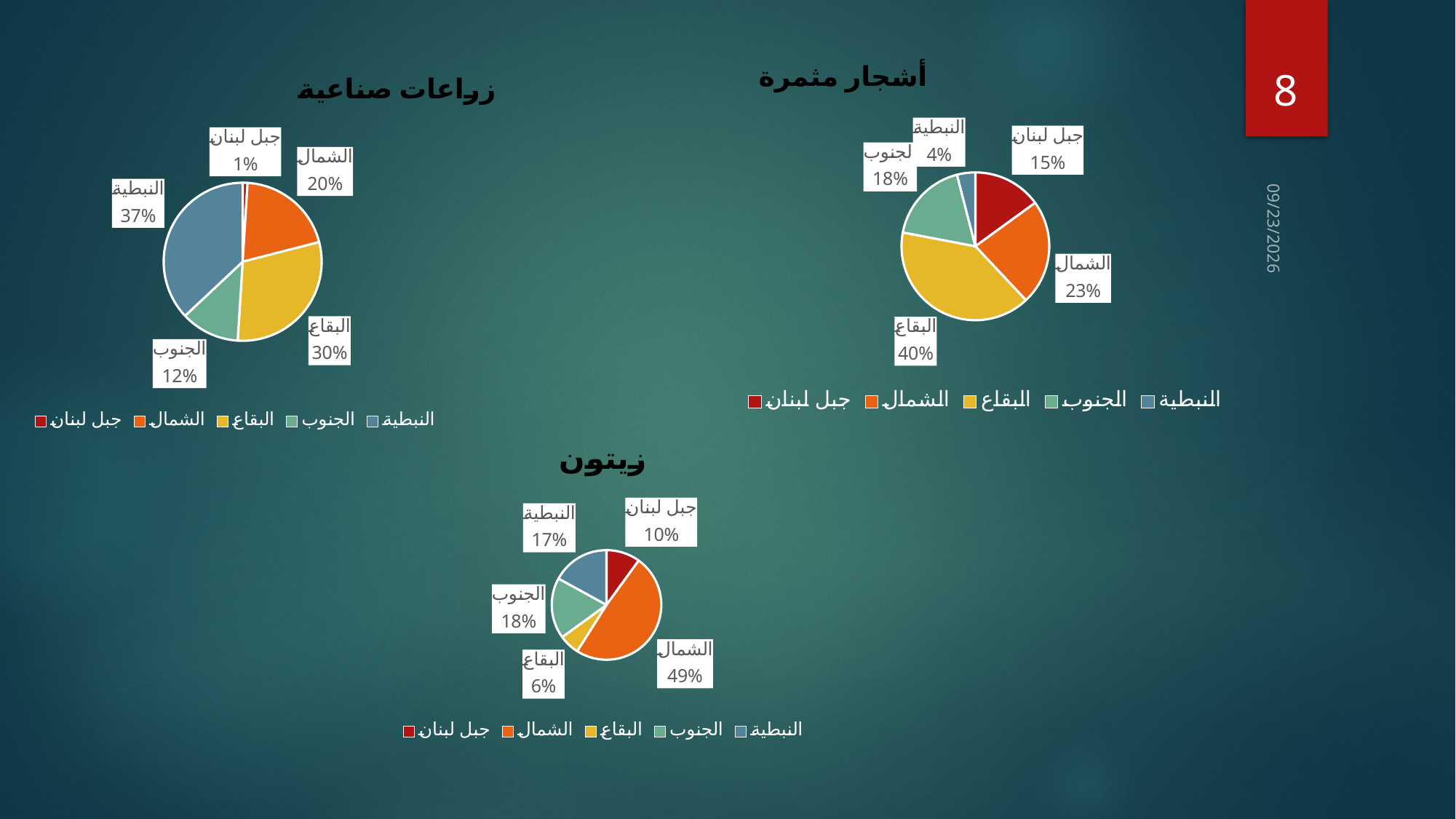
In the 'أشجار مثمرة' pie chart, which is larger, the share of جبل لبنان or the share of الجنوب? الجنوب In the 'أشجار مثمرة' pie chart, what share does الشمال have? 23% In the 'زراعات صناعية' pie chart, what is the difference between the shares of البقاع and الجنوب? 18% What type of chart is the 'زيتون' chart? Pie chart In the 'زراعات صناعية' pie chart, which region has the smallest slice? جبل لبنان In the 'زراعات صناعية' pie chart, what share does النبطية have? 37% How many entries does the legend of the 'أشجار مثمرة' chart list? 5 In the 'أشجار مثمرة' pie chart, what is the difference between the shares of البقاع and النبطية? 36% In the 'زيتون' pie chart, how many slices does the pie have? 5 In the 'أشجار مثمرة' pie chart, which region has the largest slice? البقاع In the 'زيتون' pie chart, what share does الشمال have? 49% In the 'زيتون' pie chart, which region has the smallest slice? البقاع